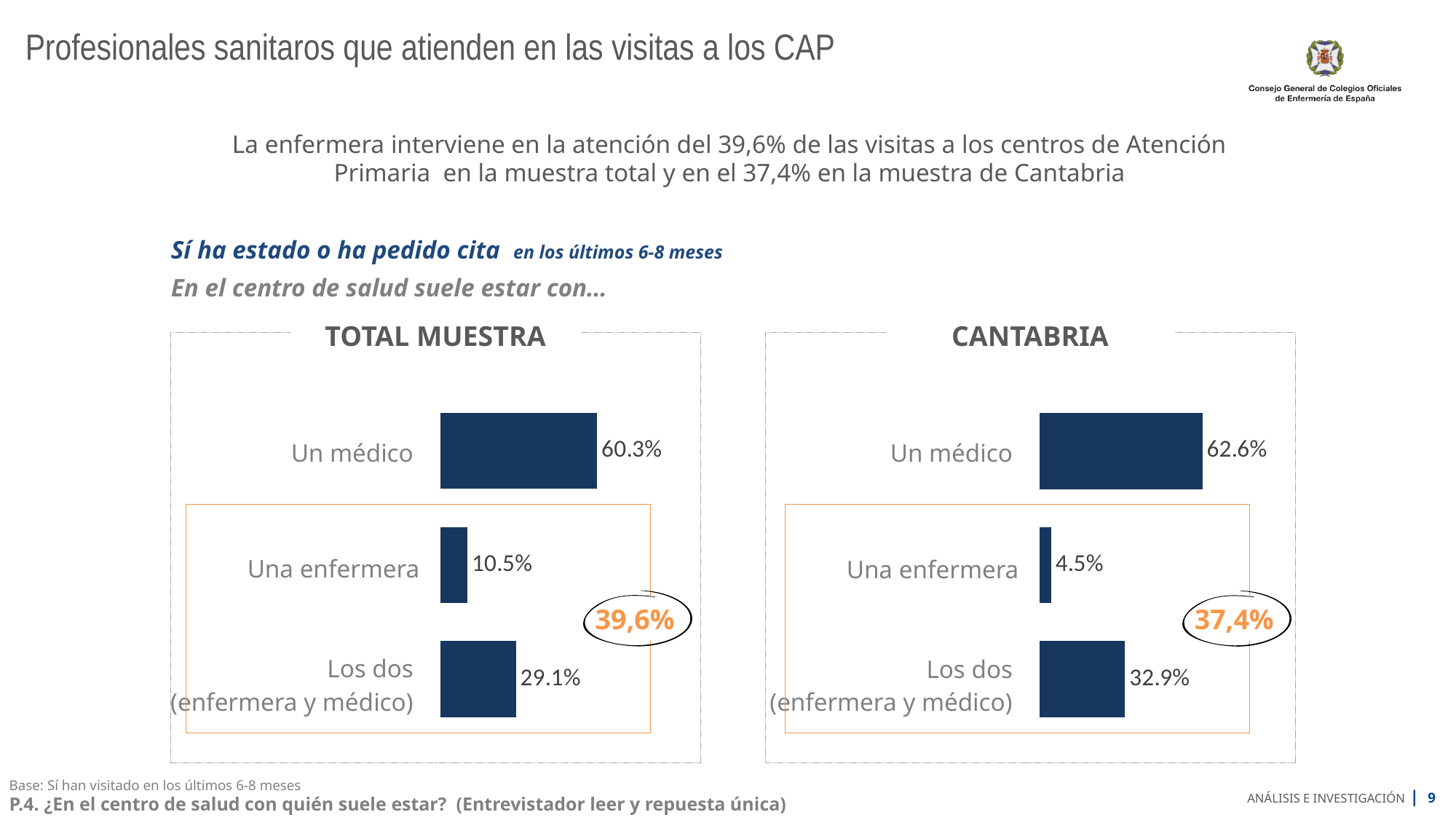
In the TOTAL MUESTRA chart, how many categories are shown? 3 In the CANTABRIA chart, what is the value for Una enfermera? 4.5% In the CANTABRIA chart, which category has the lowest value? Una enfermera In the TOTAL MUESTRA chart, which category has the highest value? Un médico Which is larger: Una enfermera in the TOTAL MUESTRA chart or Una enfermera in the CANTABRIA chart? TOTAL MUESTRA In the TOTAL MUESTRA chart, what is the value for Un médico? 60.3% What type of chart is the CANTABRIA chart? Bar chart In the TOTAL MUESTRA chart, what is the combined value of Una enfermera and Los dos (enfermera y médico)? 39.6% In the TOTAL MUESTRA chart, what is the difference between Un médico and Los dos (enfermera y médico)? 31.2% In the CANTABRIA chart, what is the difference between Los dos (enfermera y médico) and Una enfermera? 28.4% In the CANTABRIA chart, what is the value for Los dos (enfermera y médico)? 32.9% What is the title of the chart on the right side of the slide? CANTABRIA